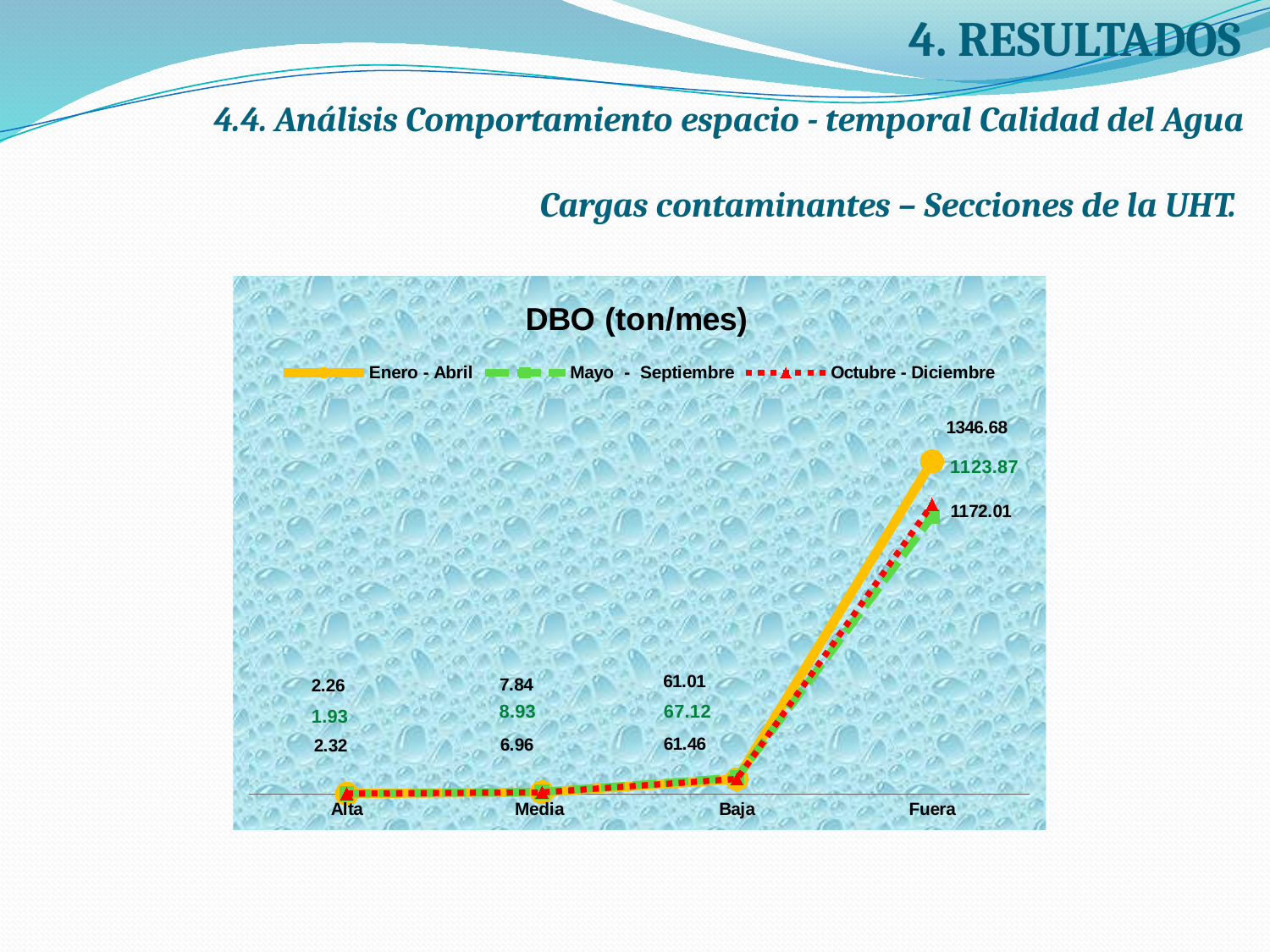
What is the value for Mayo - Septiembre at Fuera? 1123.87 How many series does the legend of the DBO (ton/mes) chart list? 3 How many categories are shown on the x axis of the DBO (ton/mes) chart? 4 What is the value for Enero - Abril at Fuera? 1346.68 At Fuera, what is the difference between the Enero - Abril value and the Mayo - Septiembre value? 222.81 At Fuera, which series has the larger value: Enero - Abril or Mayo - Septiembre? Enero - Abril Which category has the highest DBO values for all three series? Fuera What kind of chart is shown on the slide? line chart Which category has the lowest value for the Mayo - Septiembre series? Alta What is the value for Mayo - Septiembre at Media? 8.93 What is the value for Mayo - Septiembre at Baja? 67.12 Do the values rise or fall along the x axis from Alta to Fuera? rise